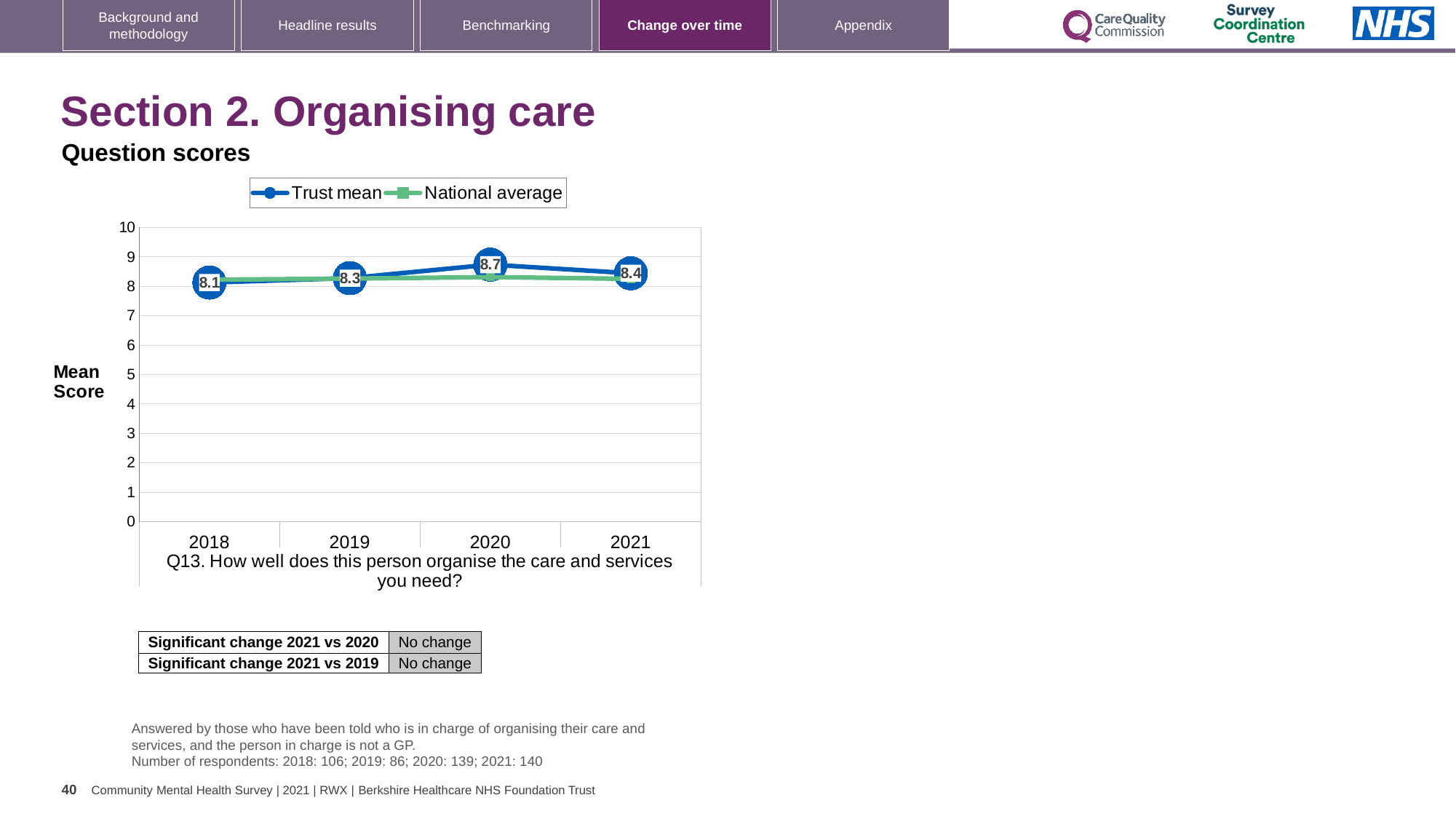
Does the Trust mean rise or fall from 2018 to 2020? Rise Which is larger, the Trust mean in 2019 or in 2021? 2021 How many series does the legend list? 2 What is the Trust mean for 2018? 8.1 What is the Trust mean for 2020? 8.7 In which year is the Trust mean lowest? 2018 What is the Trust mean for 2021? 8.4 What is the difference between the Trust mean in 2020 and in 2018? 0.6 In which year is the Trust mean highest? 2020 What kind of chart is shown? Line chart Is the National average value for 2021 greater or less than 7? greater How many years are plotted on the x axis? 4